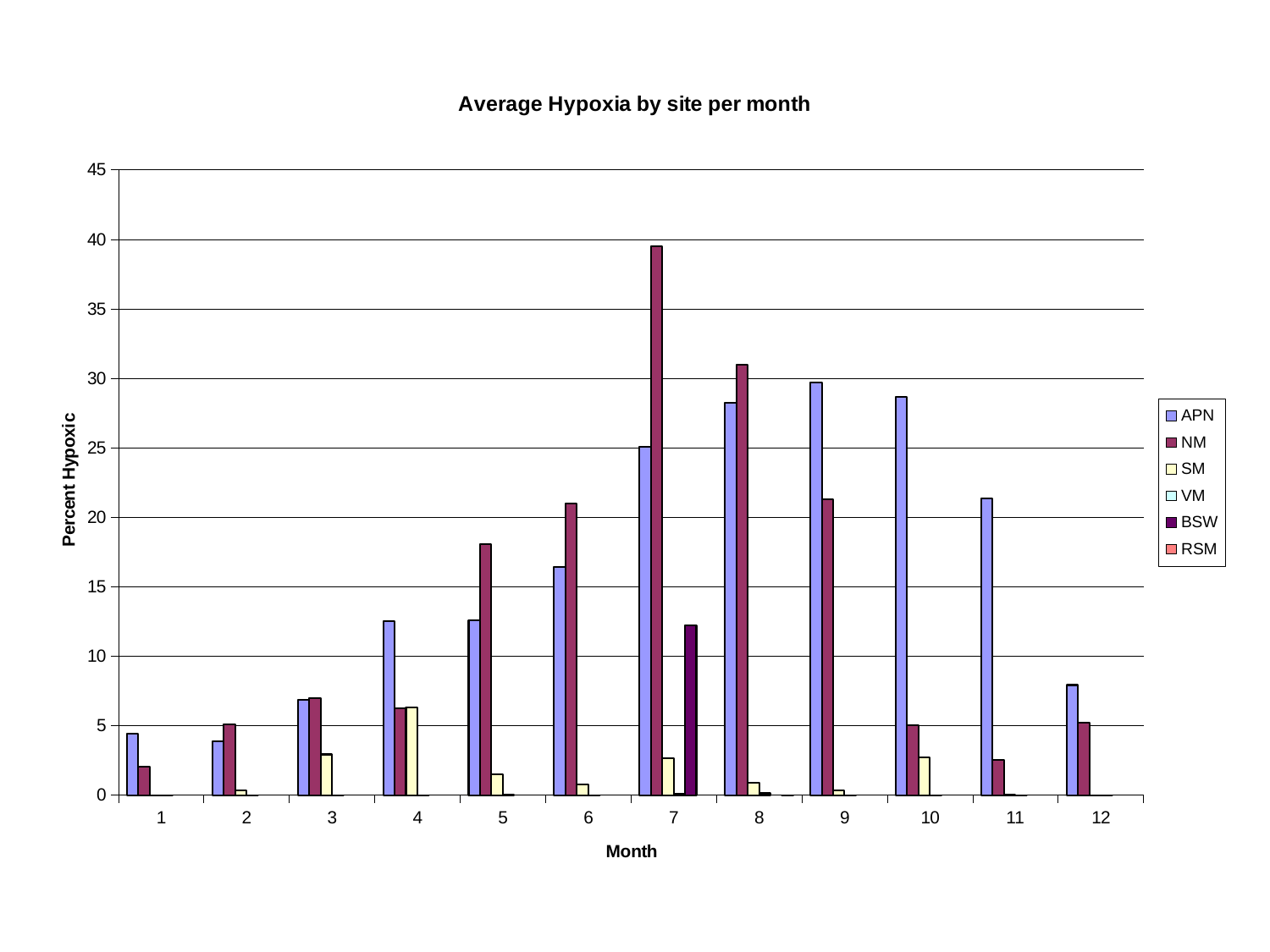
What kind of chart is shown on the slide? Bar chart In which month is the NM value highest? 7 Is the BSW value for month 7 greater or less than 10? greater Is the APN value for month 8 greater or less than 25? greater How many series does the legend list? 6 Is the NM value for month 7 greater or less than 35? greater In month 11, which is larger, APN or NM? APN How many months are shown along the x axis? 12 Do the APN values rise or fall from month 1 to month 9? rise In month 7, which is larger, APN or NM? NM What is the title of the y axis? Percent Hypoxic